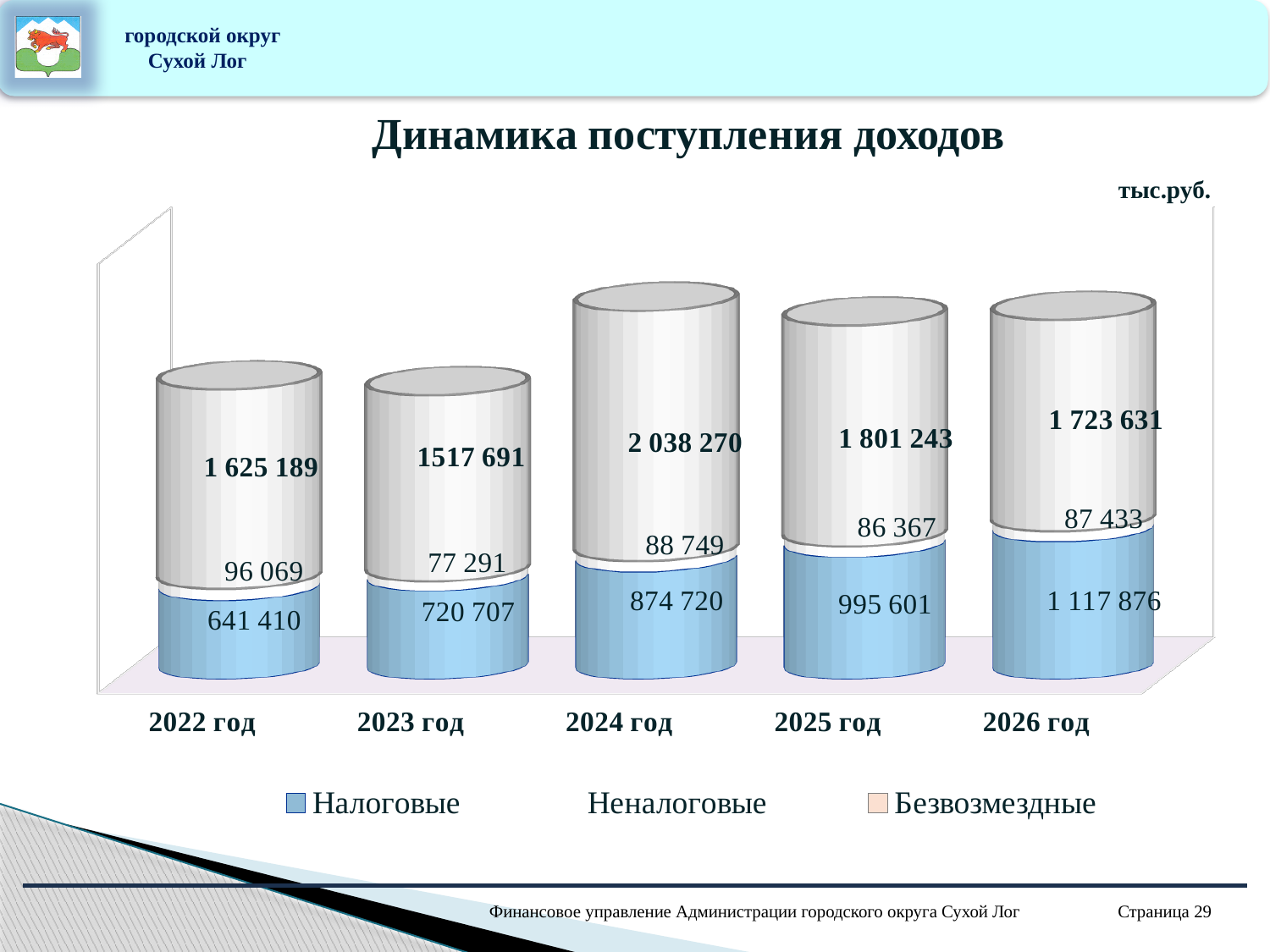
What is the difference between the Налоговые values for 2026 год and 2022 год? 476 466 How many years are shown on the x axis? 5 How many series does the legend list? 3 Which is larger: Безвозмездные in 2025 год or Безвозмездные in 2026 год? 2025 год What is the value for Налоговые in 2022 год? 641 410 What is the value for Неналоговые in 2025 год? 86 367 In which year is the Неналоговые value lowest? 2023 год What is the total of the stacked bar for 2024 год? 3 001 739 What kind of chart is shown? Stacked bar chart Do the Налоговые values rise or fall from 2022 год to 2026 год? Rise What is the value for Безвозмездные in 2024 год? 2 038 270 In which year is the Налоговые value highest? 2026 год